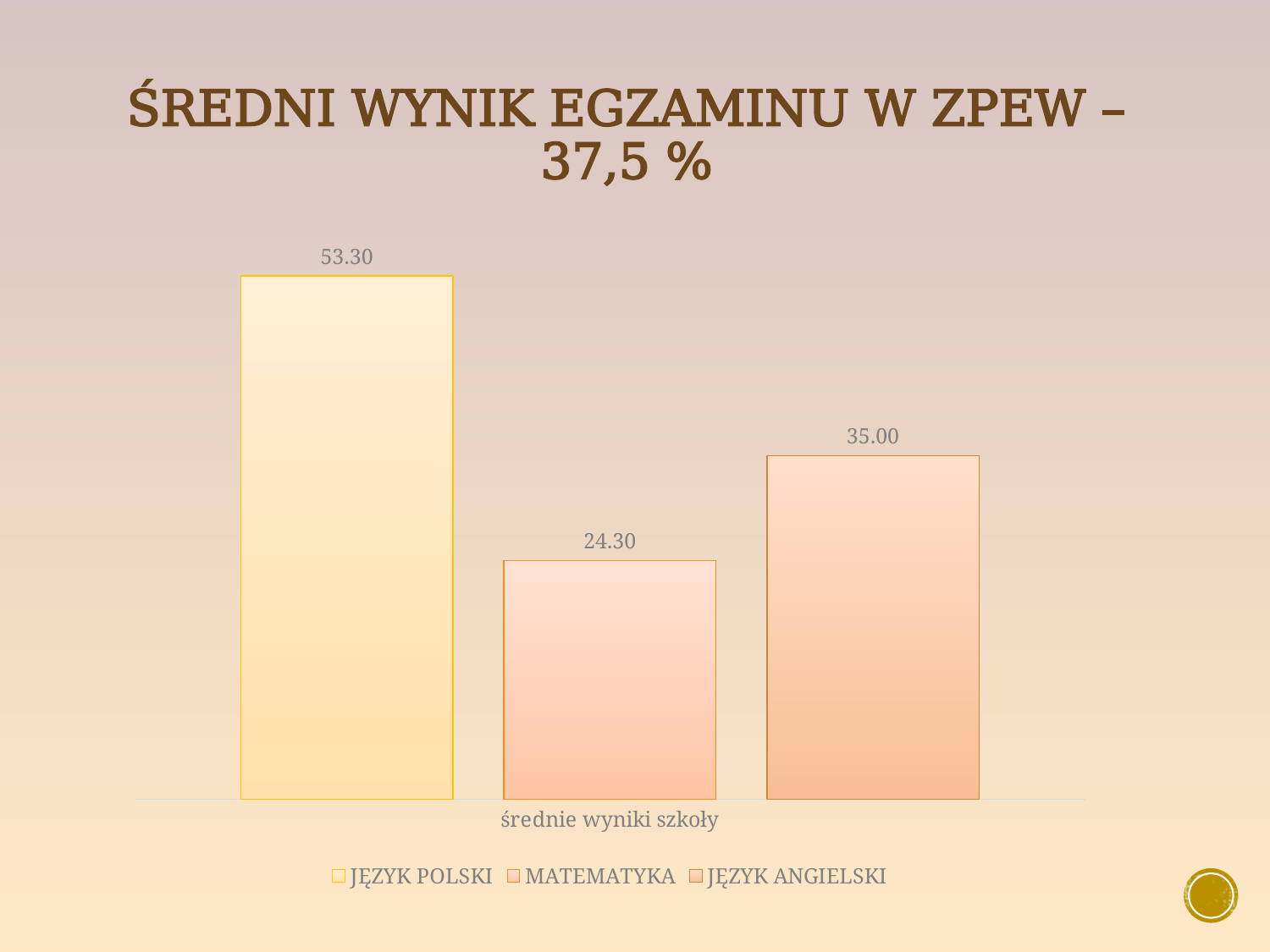
Which series has the highest value? JĘZYK POLSKI What is the value for MATEMATYKA? 24.30 What is the label on the x axis of the chart? średnie wyniki szkoły What kind of chart is shown on the slide? bar chart How many bars are plotted on the chart? 3 What is the difference between the values for JĘZYK POLSKI and MATEMATYKA? 29.00 Which is larger, the value for JĘZYK ANGIELSKI or the value for MATEMATYKA? JĘZYK ANGIELSKI How many series does the legend list? 3 Which series has the lowest value? MATEMATYKA What is the difference between the values for JĘZYK ANGIELSKI and MATEMATYKA? 10.70 What is the value for JĘZYK ANGIELSKI? 35.00 What is the value for JĘZYK POLSKI? 53.30